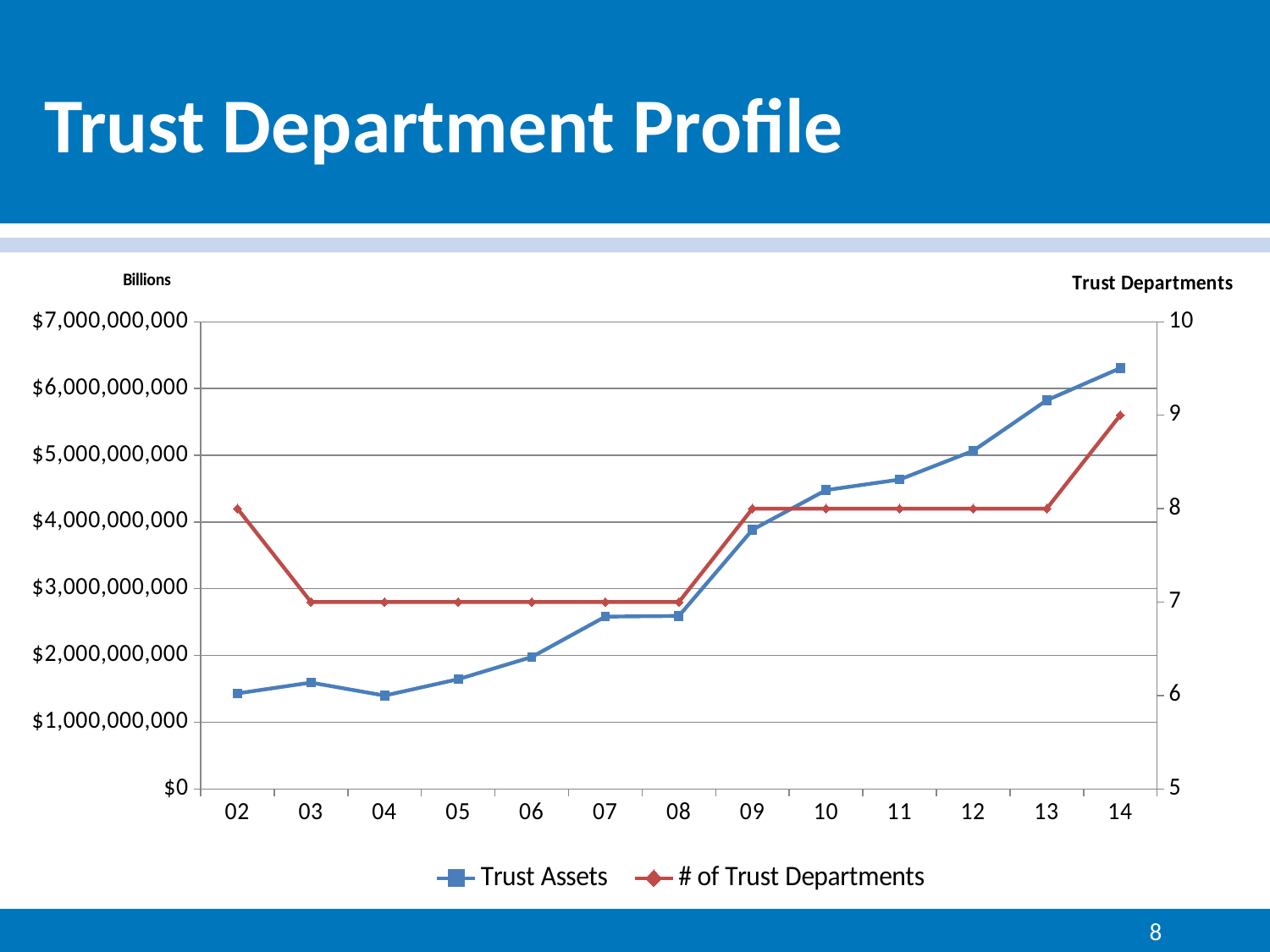
What kind of chart is shown on the slide? line chart Is the value for Trust Assets in 14 greater or less than $6,000,000,000? greater Is the value for Trust Assets in 02 greater or less than $2,000,000,000? less In which year is the # of Trust Departments highest? 14 How many years are plotted along the x axis? 13 What is the difference in # of Trust Departments between 14 and 08? 2 What is the # of Trust Departments in 14? 9 What is the # of Trust Departments in 05? 7 Do Trust Assets generally rise or fall from 02 to 14? rise What is the # of Trust Departments in 10? 8 Which year has more Trust Departments, 02 or 03? 02 How many series does the legend list? 2